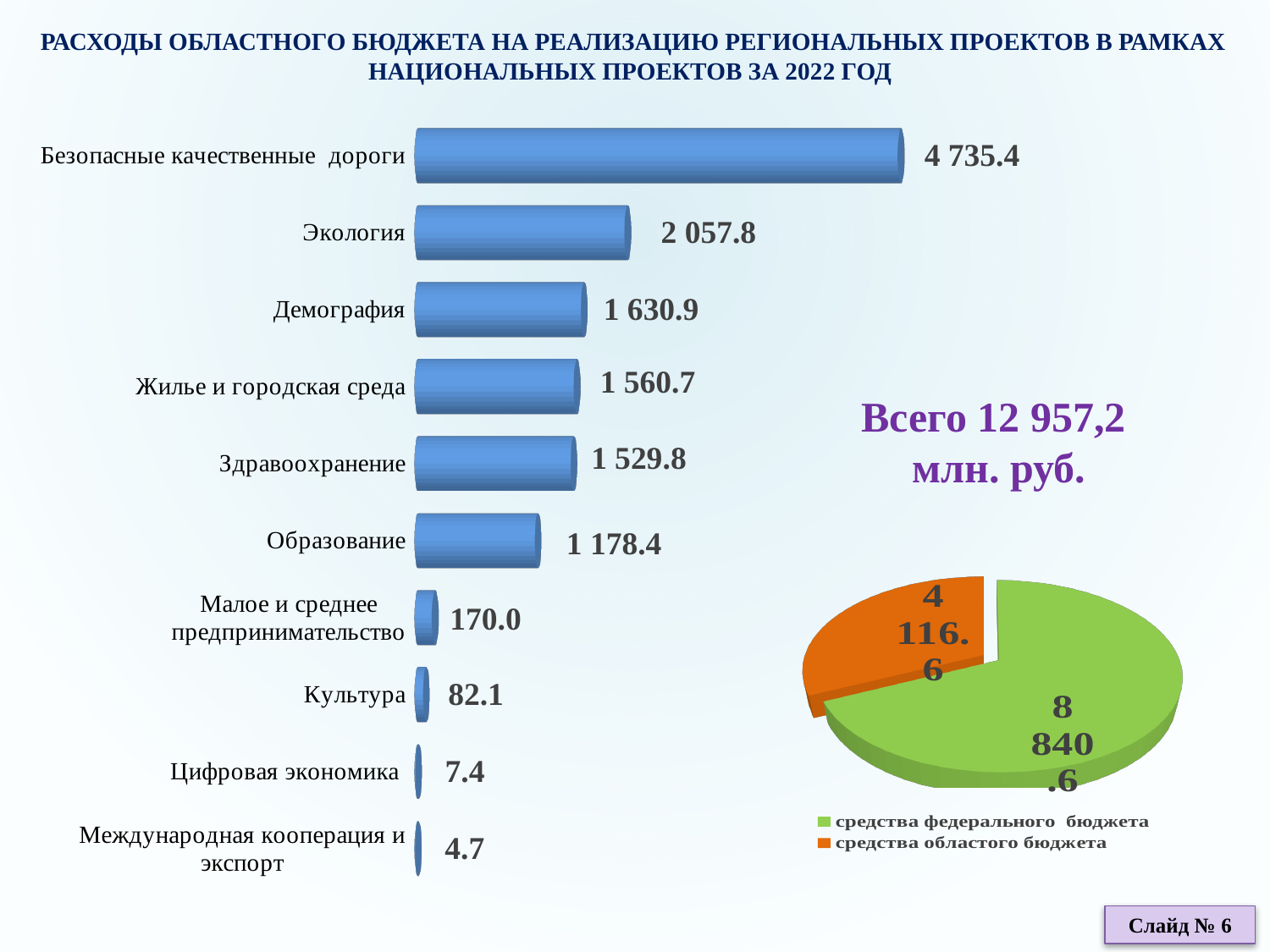
On the bar chart, what is the value for Международная кооперация и экспорт? 4.7 How many categories does the bar chart show? 10 On the pie chart, what is the value for средства областного бюджета? 4 116.6 On the pie chart, which slice is larger: средства федерального бюджета or средства областного бюджета? средства федерального бюджета On the bar chart, what is the value for Здравоохранение? 1 529.8 On the bar chart, what is the difference between the values for Безопасные качественные дороги and Экология? 2 677.6 On the bar chart, which category has the highest value? Безопасные качественные дороги On the bar chart, what is the value for Экология? 2 057.8 On the bar chart, what is the difference between the values for Малое и среднее предпринимательство and Культура? 87.9 What kind of chart is the chart on the left of the slide? bar chart On the bar chart, which is larger: the value for Демография or the value for Жилье и городская среда? Демография On the bar chart, which category has the lowest value? Международная кооперация и экспорт